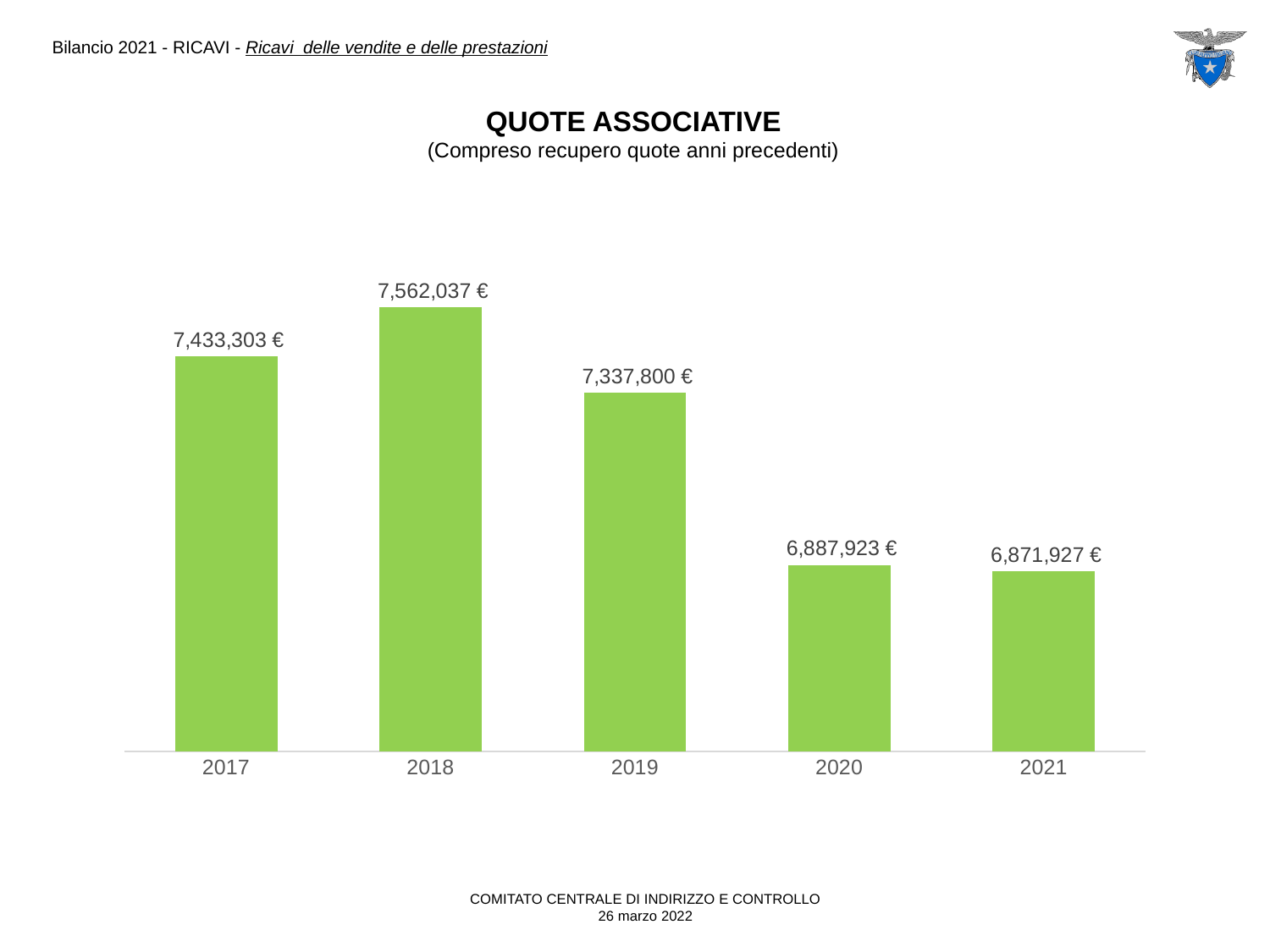
What is the value for 2021? 6,871,927 € What is the difference between the values for 2019 and 2020? 449,877 € From 2018 to 2021, do the values rise or fall? Fall How many years are shown on the x axis? 5 What kind of chart is this? Bar chart What is the title of the chart? QUOTE ASSOCIATIVE What is the difference between the values for 2018 and 2017? 128,734 € What is the value for 2017? 7,433,303 € Which year has the highest value? 2018 Which is larger, the value for 2017 or the value for 2019? 2017 Which year has the lowest value? 2021 What is the value for 2019? 7,337,800 €